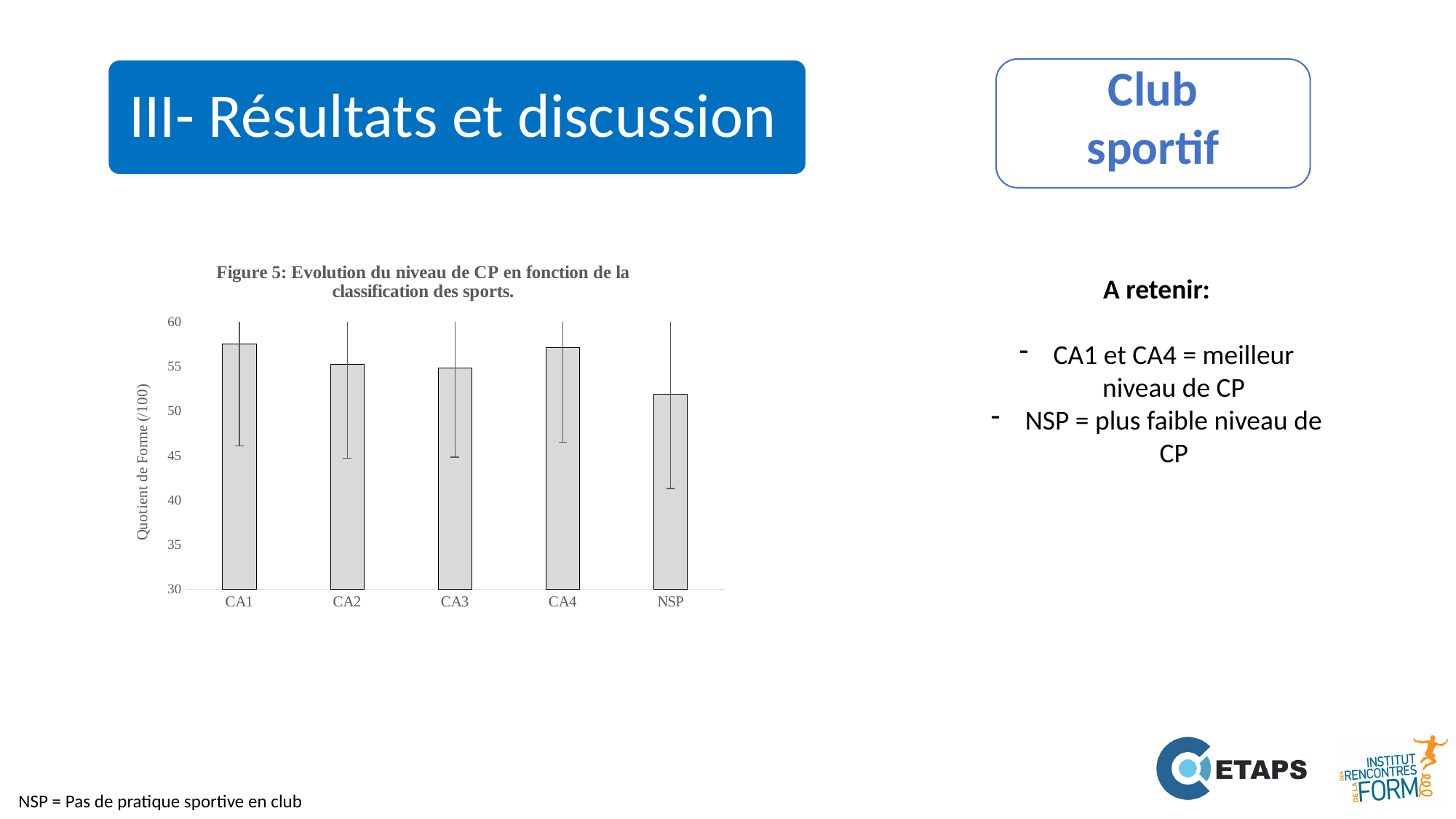
Which category has the lowest value in the chart? NSP Which is larger, the value for CA1 or the value for NSP? CA1 Is the value for CA3 greater or less than 50? greater Which is larger, the value for CA4 or the value for CA3? CA4 Is the value for NSP greater or less than 55? less What is the title of the chart? Figure 5: Evolution du niveau de CP en fonction de la classification des sports. What kind of chart is shown on the slide? bar chart How many categories are shown on the x axis of the chart? 5 Is the value for CA4 greater or less than 55? greater What is the label of the y axis of the chart? Quotient de Forme (/100)